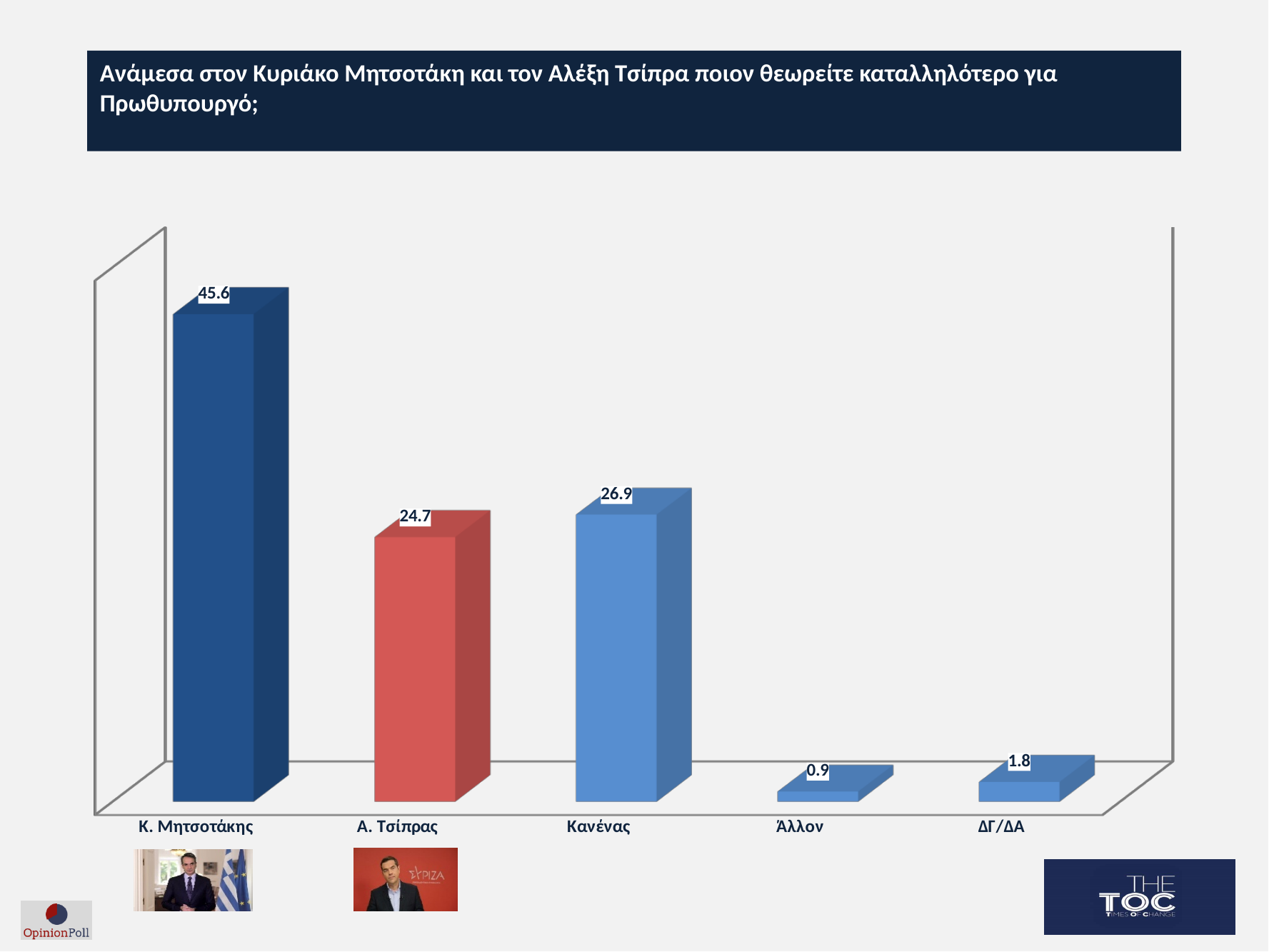
What is the difference between the values for Κ. Μητσοτάκης and Α. Τσίπρας? 20.9 What is the value for Α. Τσίπρας? 24.7 Which is larger, the value for Κανένας or the value for Α. Τσίπρας? Κανένας Which category has the highest value? Κ. Μητσοτάκης What kind of chart is shown on the slide? Bar chart What is the value for ΔΓ/ΔΑ? 1.8 How many categories are shown on the chart? 5 What is the value for Κανένας? 26.9 What is the value for Άλλον? 0.9 What is the value for Κ. Μητσοτάκης? 45.6 Which category has the lowest value? Άλλον What colour is the bar for Α. Τσίπρας? Red